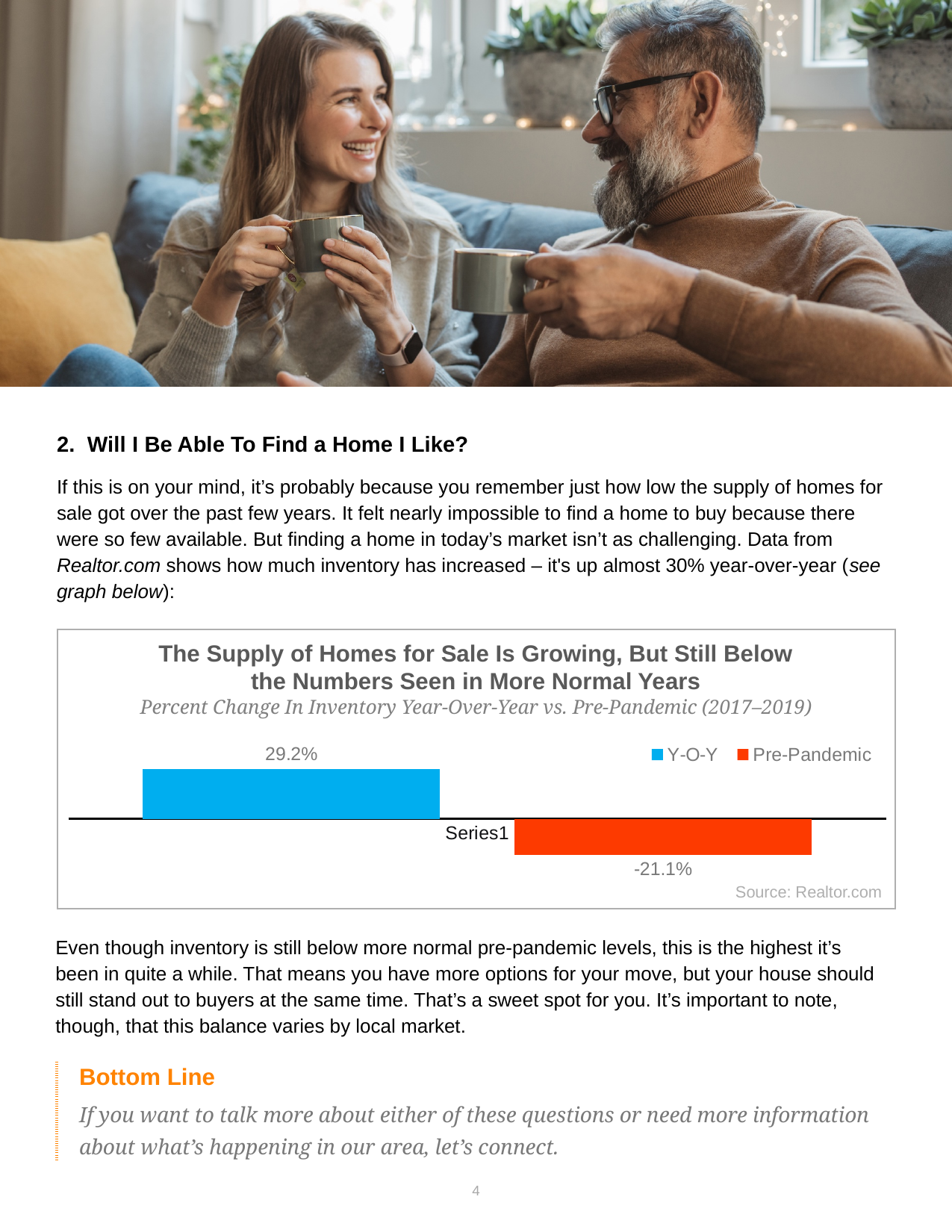
How many series does the legend list? 2 Which series has the higher value, Y-O-Y or Pre-Pandemic? Y-O-Y Which series is shown in blue? Y-O-Y What is the value for the Pre-Pandemic series? -21.1% What kind of chart is shown? Bar chart What is the value for the Y-O-Y series? 29.2% What is the source cited for the chart? Realtor.com Which series has the lowest value? Pre-Pandemic Is the Pre-Pandemic value positive or negative? Negative What is the difference between the Y-O-Y value and the Pre-Pandemic value? 50.3 percentage points